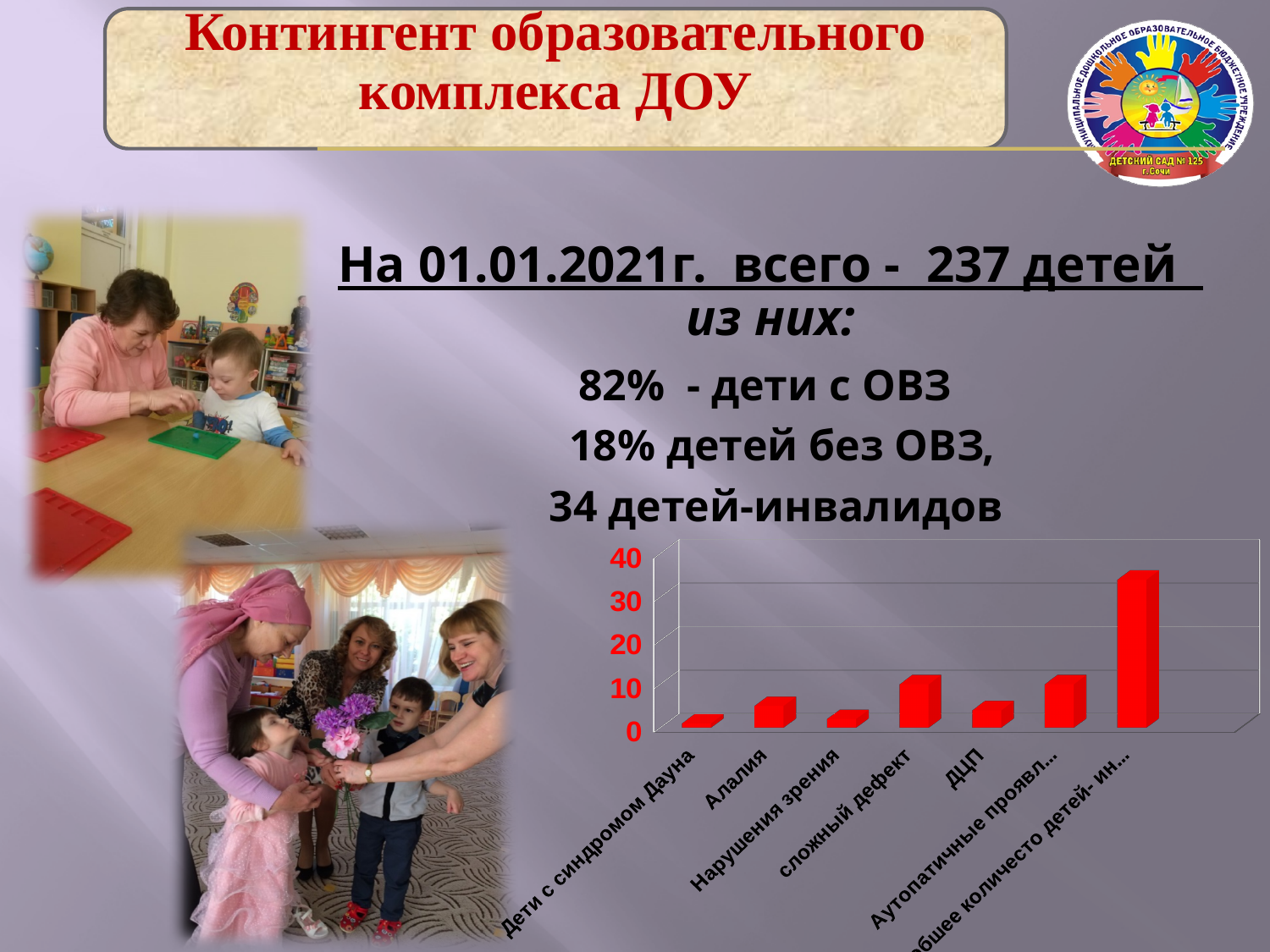
Is the value for Алалия greater or less than 10? less Is the value for сложный дефект greater or less than 20? less What kind of chart is shown on the slide? bar chart What is the highest value shown on the chart's vertical axis? 40 Is the value for ДЦП greater or less than 10? less Which category has the highest bar in the chart? Общее количество детей-ин... Which is larger, the value for сложный дефект or the value for ДЦП? сложный дефект How many categories are shown on the x axis of the chart? 7 What colour are the bars in the chart? red Which is larger, the value for Общее количество детей-ин... or the value for Алалия? Общее количество детей-ин...